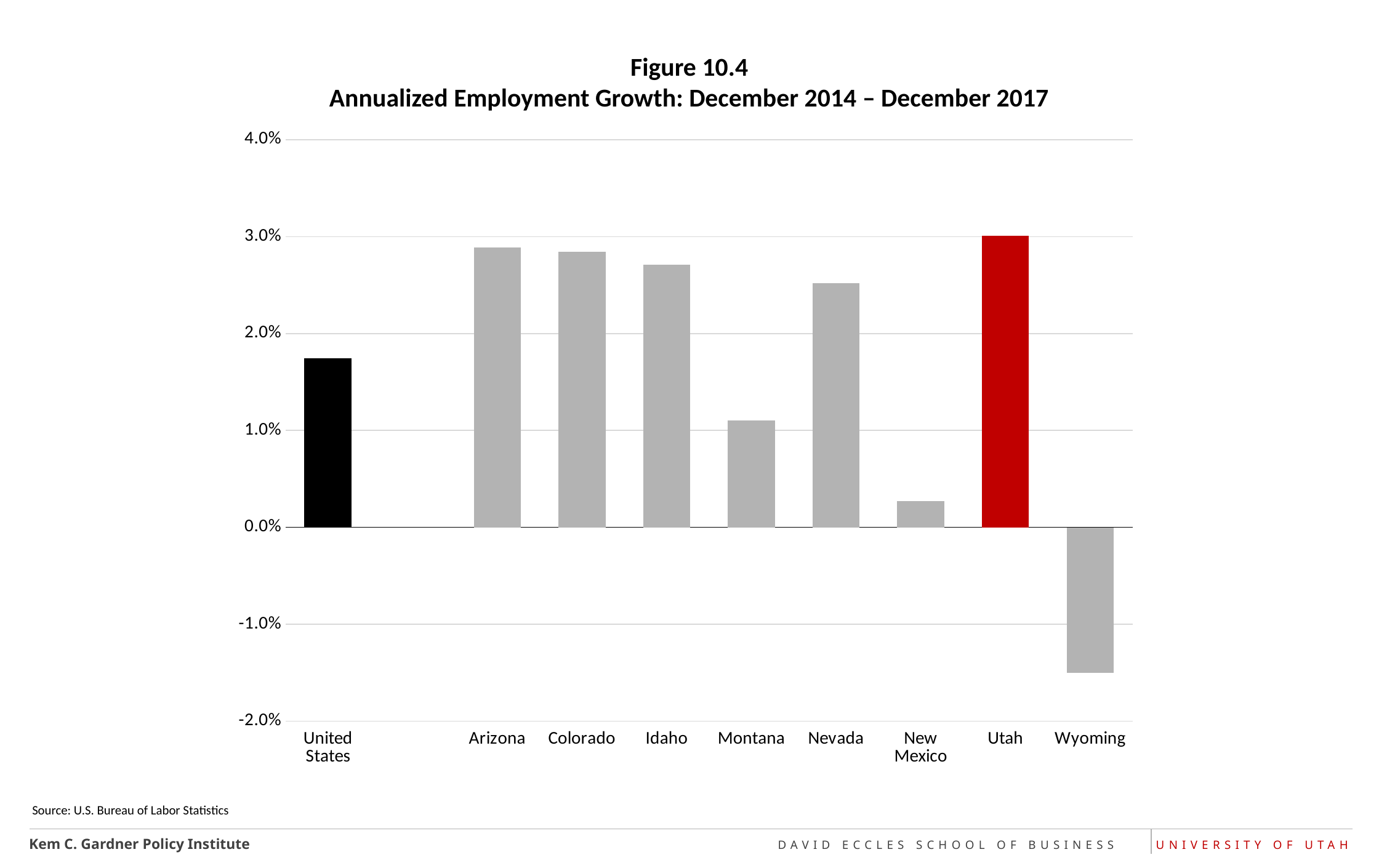
Is the value for New Mexico greater or less than 1.0%? less Is the value for the United States greater or less than 2.0%? less Which has the larger value, Arizona or Montana? Arizona Which category's bar is coloured red? Utah Which category has the highest annualized employment growth? Utah What kind of chart is shown on the slide? bar chart How many categories are plotted on the x axis? 9 Which category has the lowest annualized employment growth? Wyoming Is the value for Nevada greater or less than 2.0%? greater Which has the larger value, Idaho or Nevada? Idaho